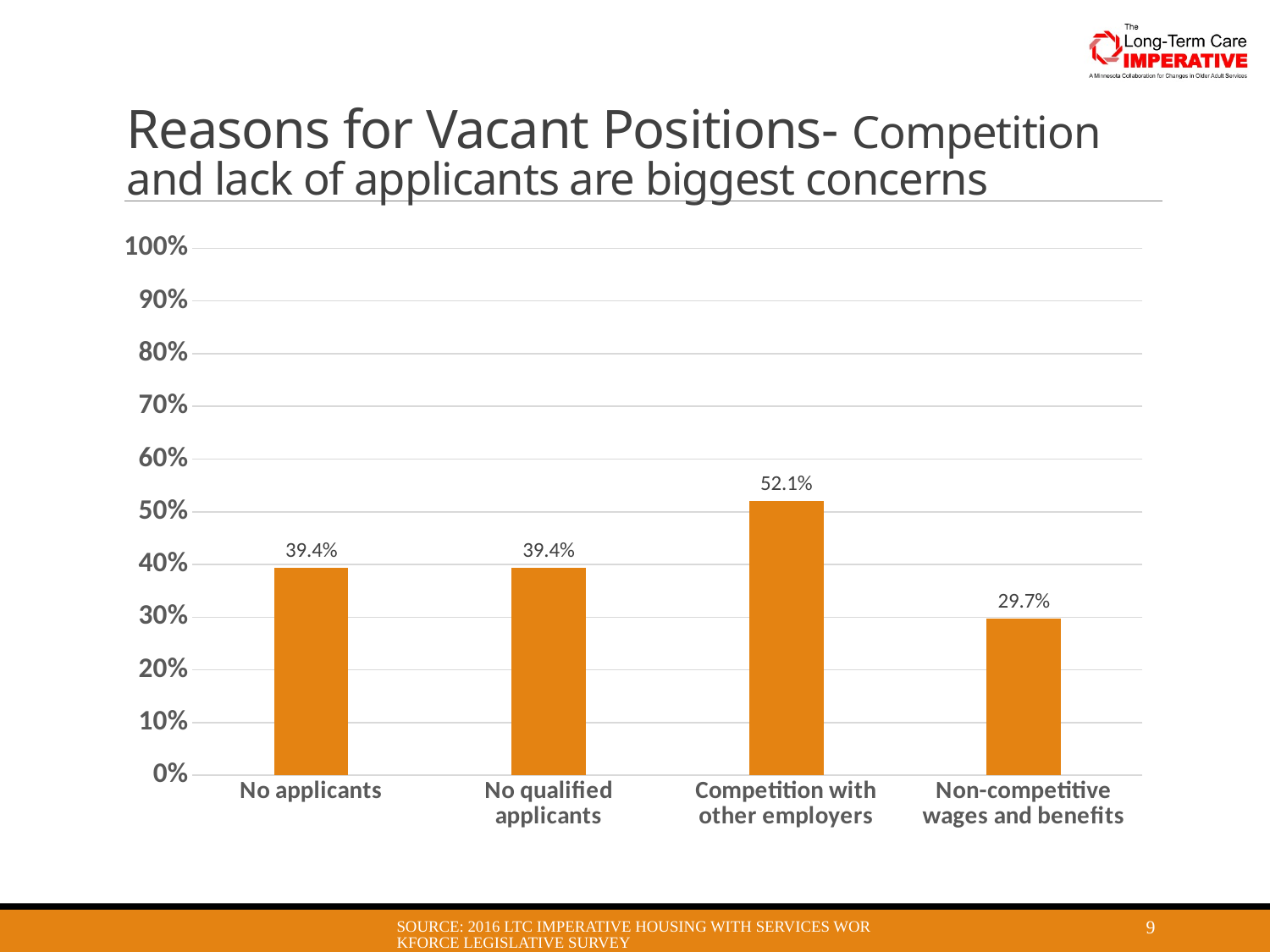
Which is larger, the value for No qualified applicants or the value for Non-competitive wages and benefits? No qualified applicants Is the value for Competition with other employers greater or less than 50%? greater What is the value for No qualified applicants? 39.4% What is the difference between the values for Competition with other employers and No applicants? 12.7% What is the value for Non-competitive wages and benefits? 29.7% How many categories are shown on the chart? 4 Which category has the lowest value? Non-competitive wages and benefits What kind of chart is shown on the slide? Bar chart Which category has the highest value? Competition with other employers What is the value for Competition with other employers? 52.1% What is the difference between the values for Competition with other employers and Non-competitive wages and benefits? 22.4% What is the value for No applicants? 39.4%